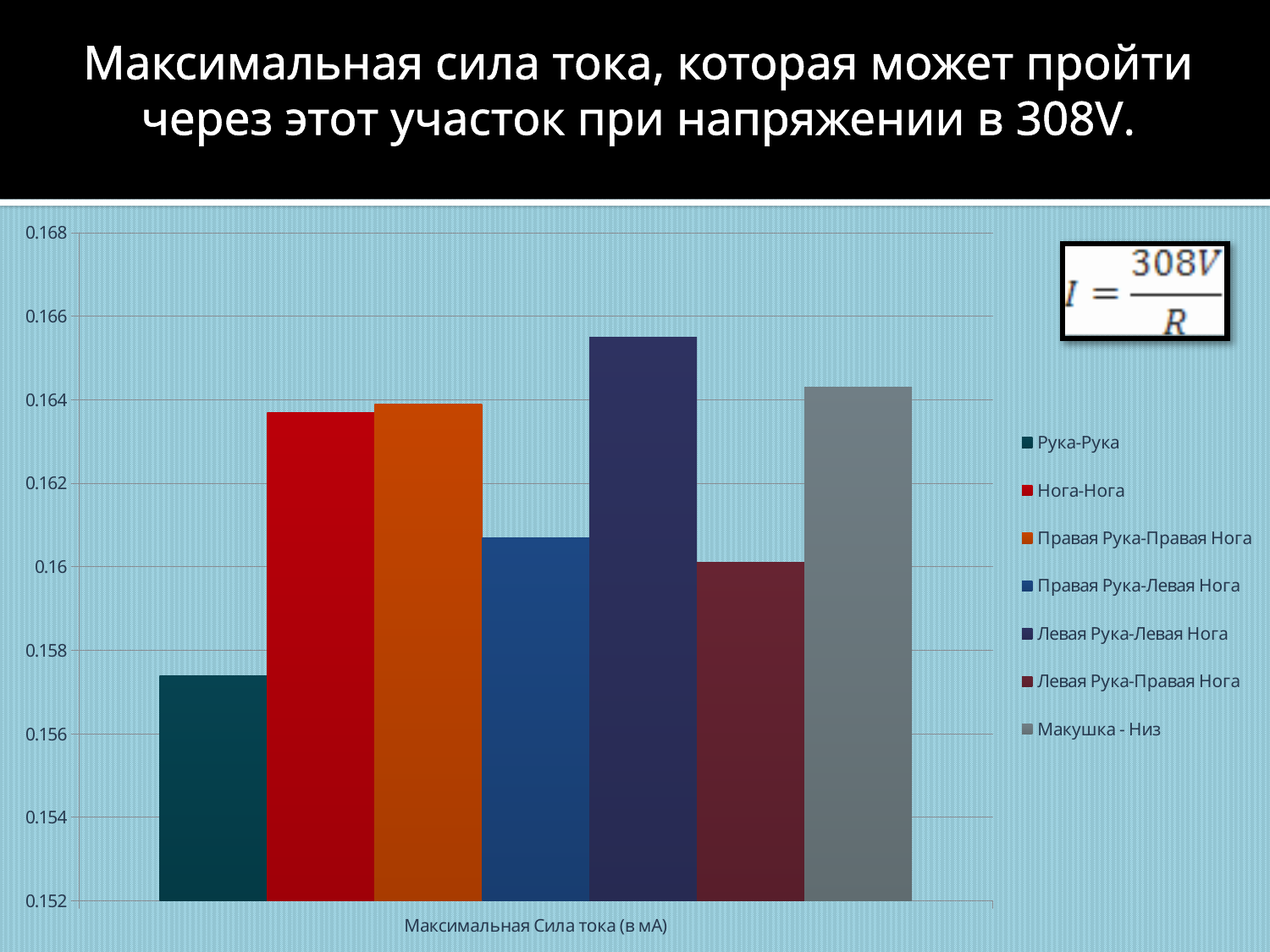
Which series has the highest value? Левая Рука-Левая Нога What kind of chart is shown on the slide? bar chart Is the value for Левая Рука-Правая Нога greater or less than 0.162? less Is the value for Левая Рука-Левая Нога greater or less than 0.164? greater Is the value for Рука-Рука greater or less than 0.158? less Which is larger, the value for Левая Рука-Левая Нога or the value for Макушка - Низ? Левая Рука-Левая Нога What is the label shown on the horizontal axis of the chart? Максимальная Сила тока (в мА) What colour is the bar for Макушка - Низ? grey Which series has the lowest value? Рука-Рука Which is larger, the value for Рука-Рука or the value for Правая Рука-Левая Нога? Правая Рука-Левая Нога How many series does the legend list? 7